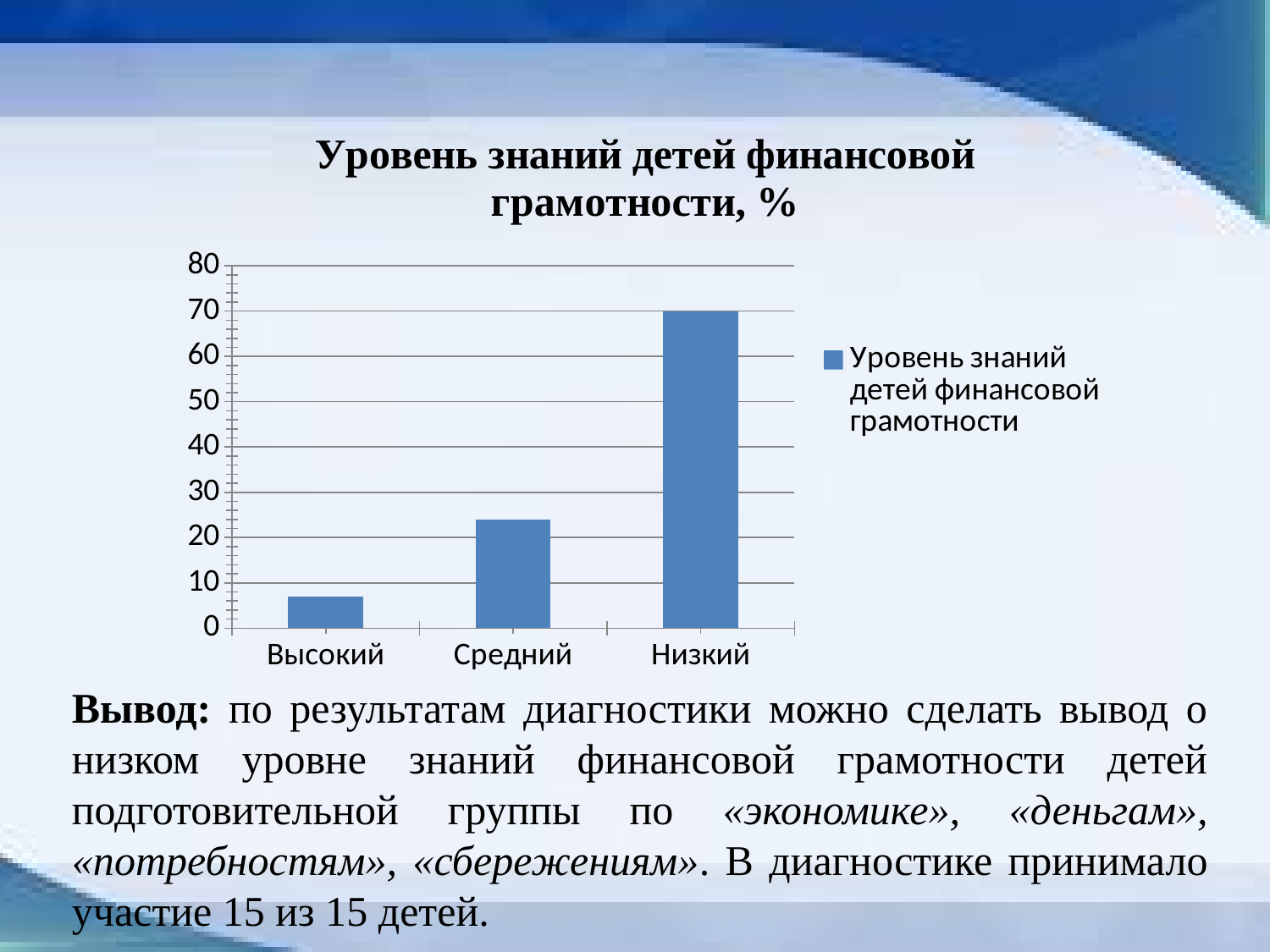
Which category has the highest value in the chart? Низкий How many categories are shown on the x axis of the chart? 3 Which category has the lowest value in the chart? Высокий Is the value for Средний greater or less than 20? greater What is the value for Низкий in the chart? 70 Which is larger, the value for Средний or the value for Высокий? Средний Do the values rise or fall moving from Высокий to Низкий along the x axis? rise How many series does the chart's legend list? 1 What is the title of the chart? Уровень знаний детей финансовой грамотности, % Is the value for Средний greater or less than 30? less What kind of chart is shown on the slide? bar chart Is the value for Высокий greater or less than 10? less